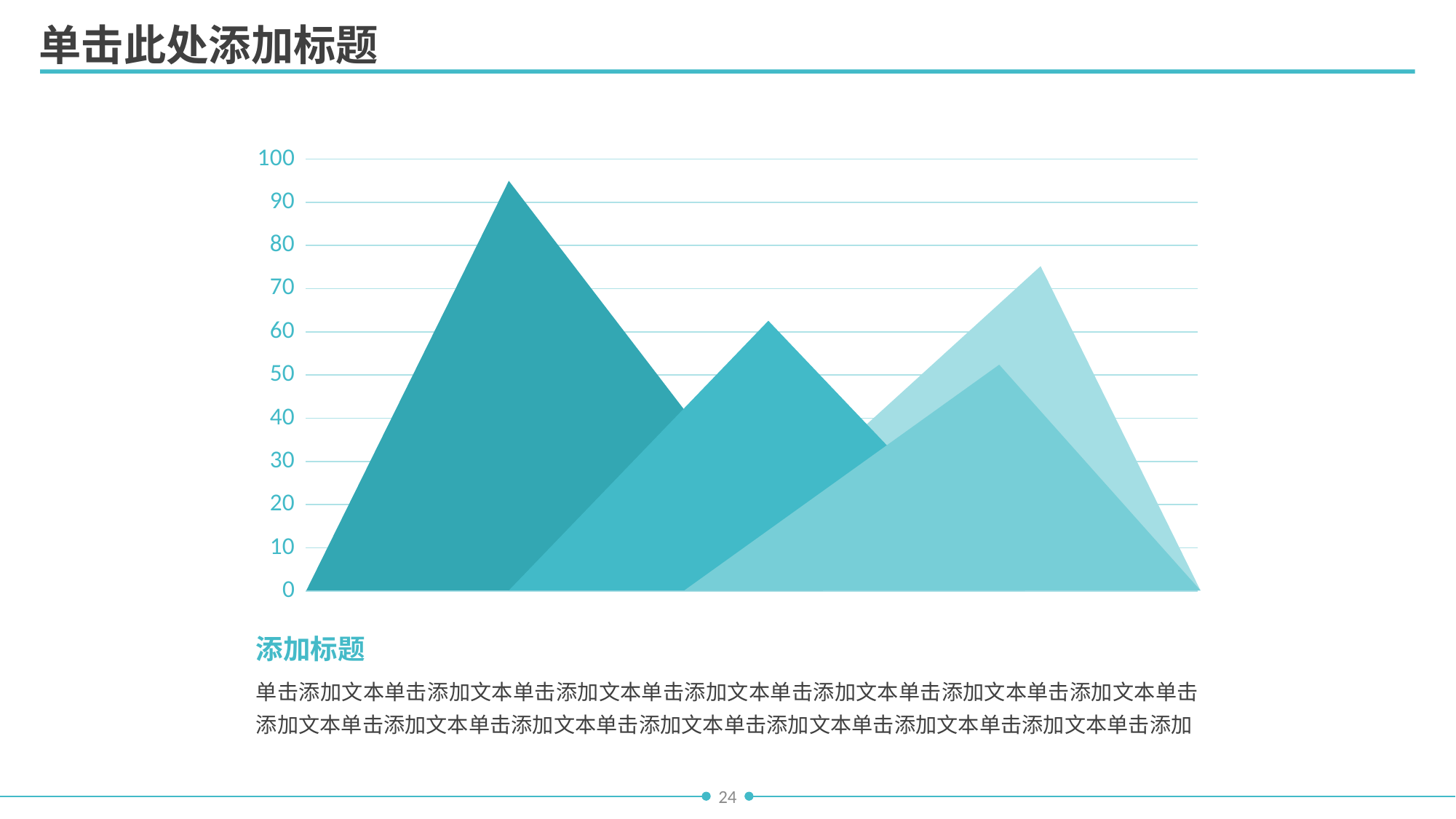
What is the maximum value shown on the vertical axis? 100 Which series reaches the highest peak, the darkest teal area or the lightest teal area? the darkest teal area What kind of chart is shown on the slide? area chart How many shaded series are plotted in the chart? 4 Is the highest peak of the lightest teal area greater or less than 70? greater Is the peak of the medium teal area greater or less than 70? less Does the chart display a legend? No Is the highest peak of the darkest teal area greater or less than 90? greater